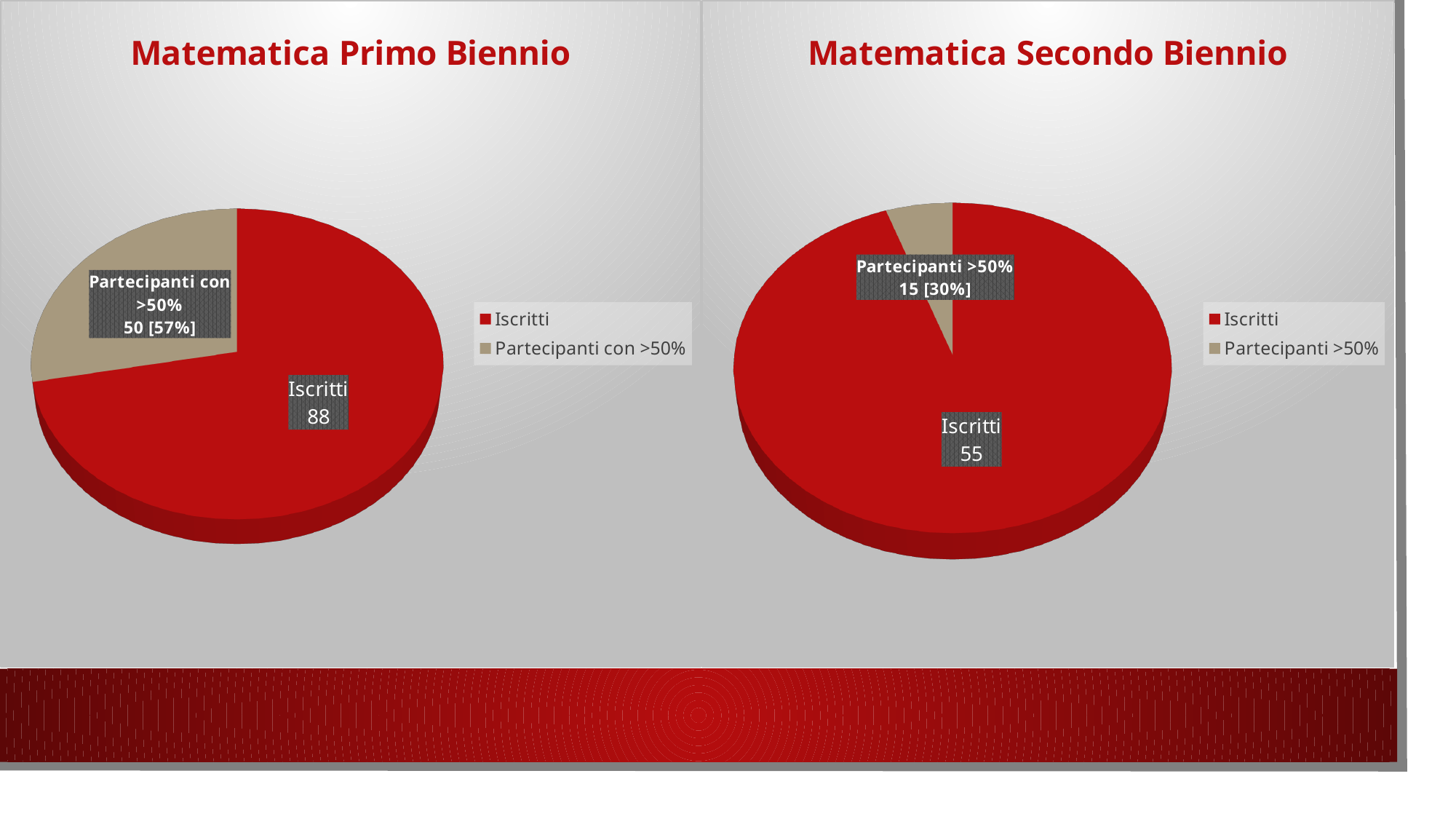
What kind of chart is the Matematica Primo Biennio chart? Pie chart How many slices does the Matematica Secondo Biennio chart have? 2 In the Matematica Secondo Biennio chart, what is the difference between the Iscritti value and the Partecipanti >50% value? 40 In the Matematica Secondo Biennio chart, what is the value for Iscritti? 55 In the Matematica Secondo Biennio chart, which slice is the smallest? Partecipanti >50% In the Matematica Primo Biennio chart, what data label is shown for Partecipanti con >50%? 50 [57%] In the Matematica Primo Biennio chart, what is the value for Iscritti? 88 In the Matematica Primo Biennio chart, which slice is the largest? Iscritti In the Matematica Primo Biennio chart, what is the difference between the Iscritti value and the Partecipanti con >50% value? 38 Is the Iscritti value larger in the Matematica Primo Biennio chart or in the Matematica Secondo Biennio chart? Matematica Primo Biennio In the Matematica Secondo Biennio chart, what colour is the Iscritti slice? Red In the Matematica Secondo Biennio chart, what percentage is shown in brackets for Partecipanti >50%? 30%